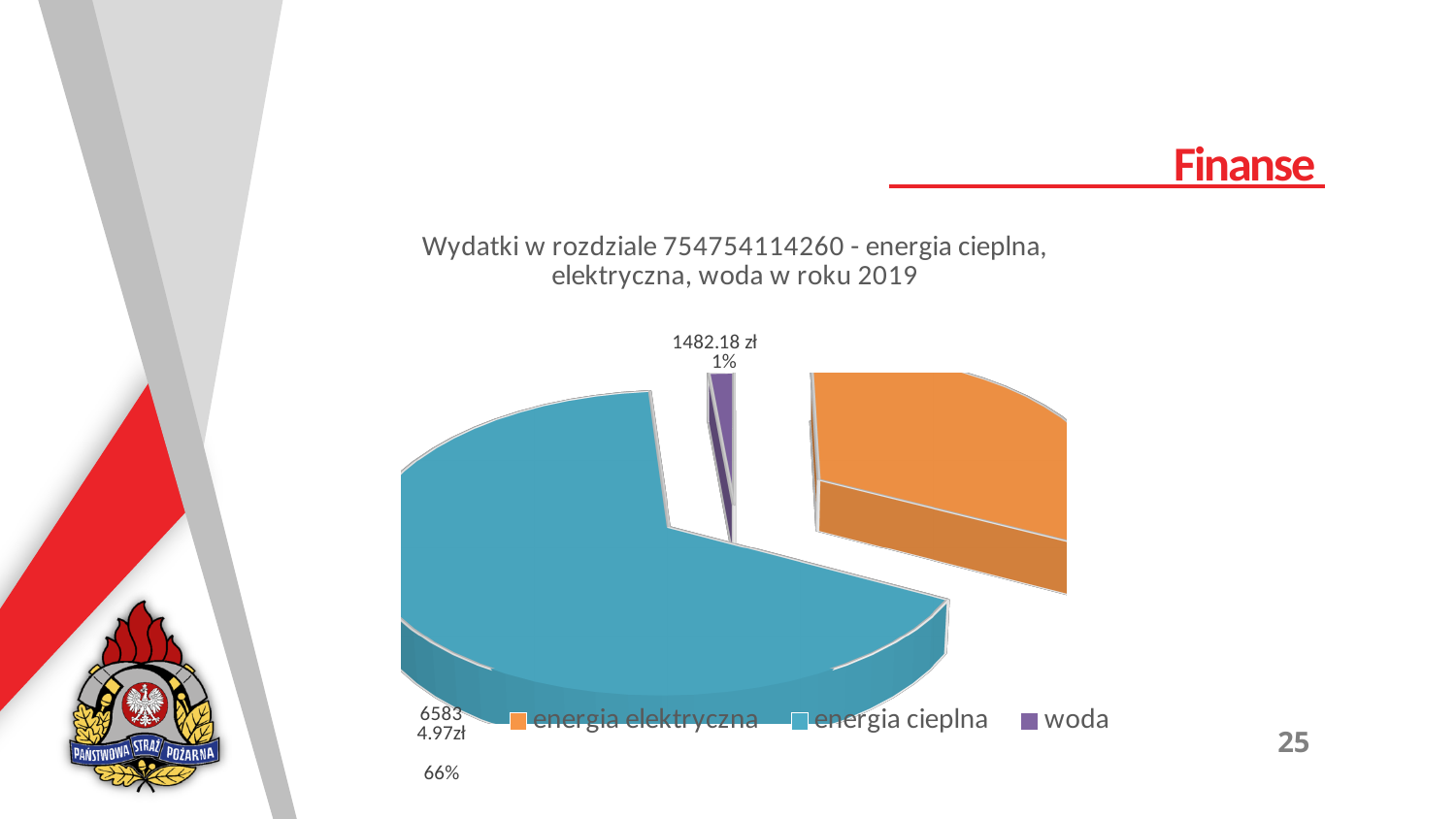
What is the title of the pie chart? Wydatki w rozdziale 754754114260 - energia cieplna, elektryczna, woda w roku 2019 Which category has the largest slice in the pie chart? energia cieplna Which is larger in the pie chart, energia elektryczna or woda? energia elektryczna What value is shown for woda in the pie chart? 1482.18 zł What share of the pie does energia cieplna represent? 66% What kind of chart is shown on the slide? pie chart What share of the pie does woda represent? 1% What colour is the woda slice in the pie chart? purple Which is larger in the pie chart, energia cieplna or energia elektryczna? energia cieplna How many slices does the pie chart have? 3 Which category has the smallest slice in the pie chart? woda How many entries does the legend of the pie chart list? 3